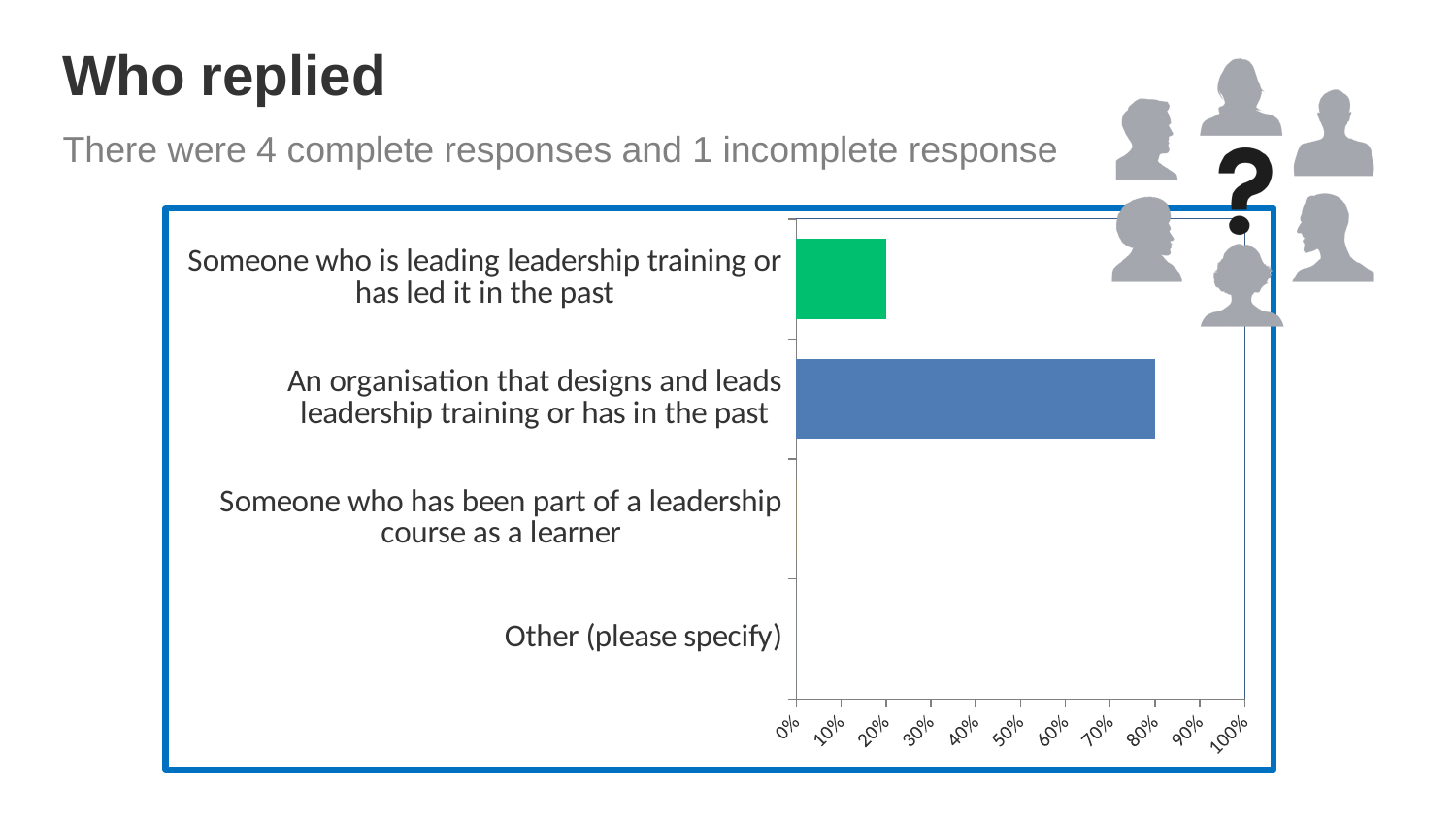
Is the value for 'An organisation that designs and leads leadership training or has in the past' greater or less than 50%? greater Does the chart show any bar for 'Other (please specify)'? No What kind of chart is shown on the slide? bar chart What is the title of the slide containing the chart? Who replied Which is larger: the value for 'Someone who is leading leadership training or has led it in the past' or the value for 'An organisation that designs and leads leadership training or has in the past'? An organisation that designs and leads leadership training or has in the past What is the difference between the values for 'An organisation that designs and leads leadership training or has in the past' and 'Someone who is leading leadership training or has led it in the past'? 60% What is the value for 'An organisation that designs and leads leadership training or has in the past'? 80% Which category has the highest value? An organisation that designs and leads leadership training or has in the past How many categories are listed on the chart? 4 What colour is the bar for 'Someone who is leading leadership training or has led it in the past'? green Is the value for 'Someone who is leading leadership training or has led it in the past' greater or less than 50%? less What is the value for 'Someone who is leading leadership training or has led it in the past'? 20%